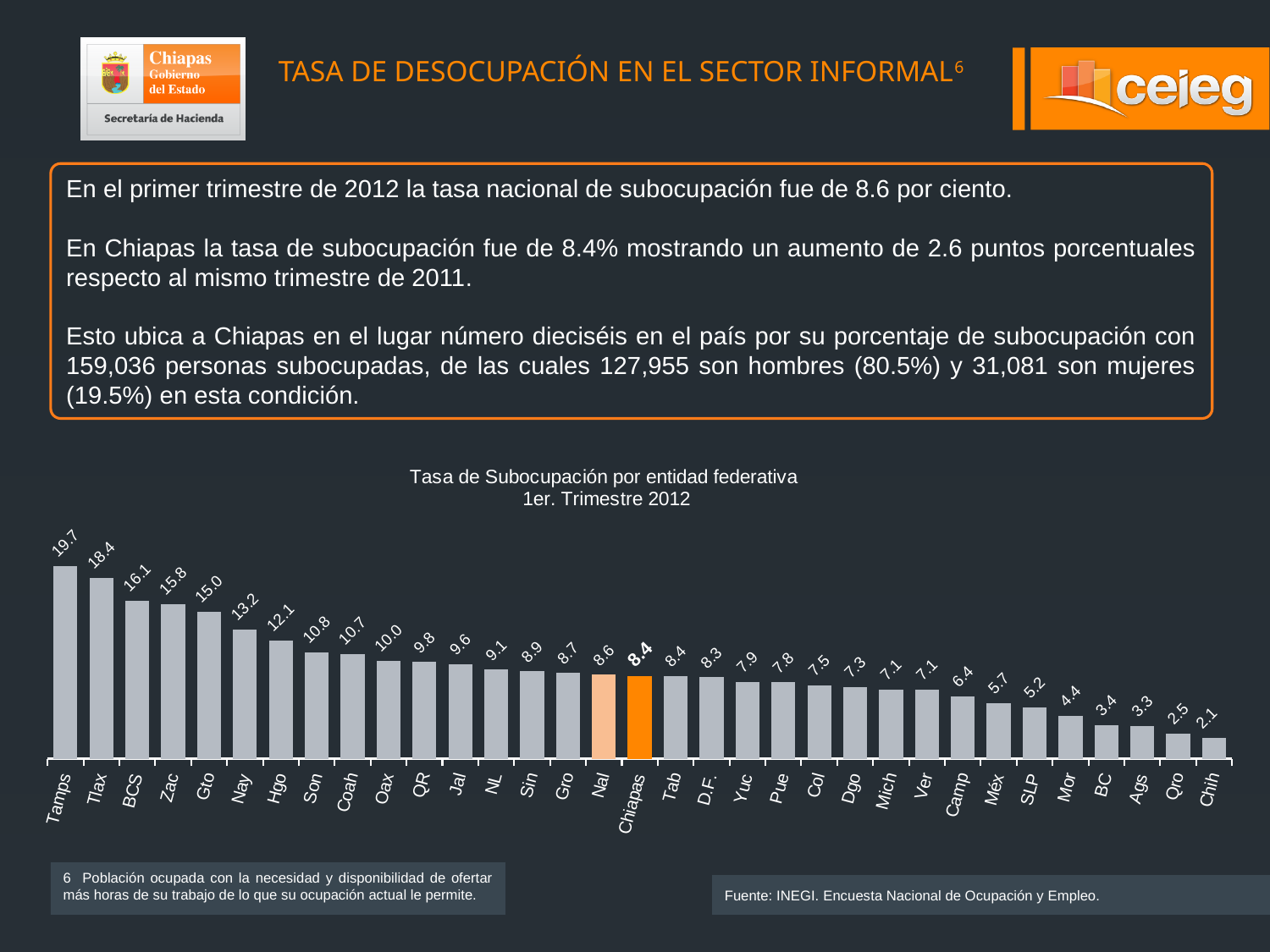
Which entity has the lowest subocupación rate in the chart? Chih How many bars are plotted in the chart? 33 Which entity has the highest subocupación rate in the chart? Tamps Which has a higher value, Zac or Gto? Zac What is the value for Tamps in the chart? 19.7 What is the value for Chih in the chart? 2.1 What is the difference between the Nal value and the Chiapas value? 0.2 What is the value shown for Nal (national) in the chart? 8.6 Do the values rise or fall moving from left to right along the x axis? Fall What is the difference between the values for Tamps and Tlax? 1.3 What is the value for Chiapas in the chart 'Tasa de Subocupación por entidad federativa'? 8.4 What type of chart is shown on the slide? Bar chart